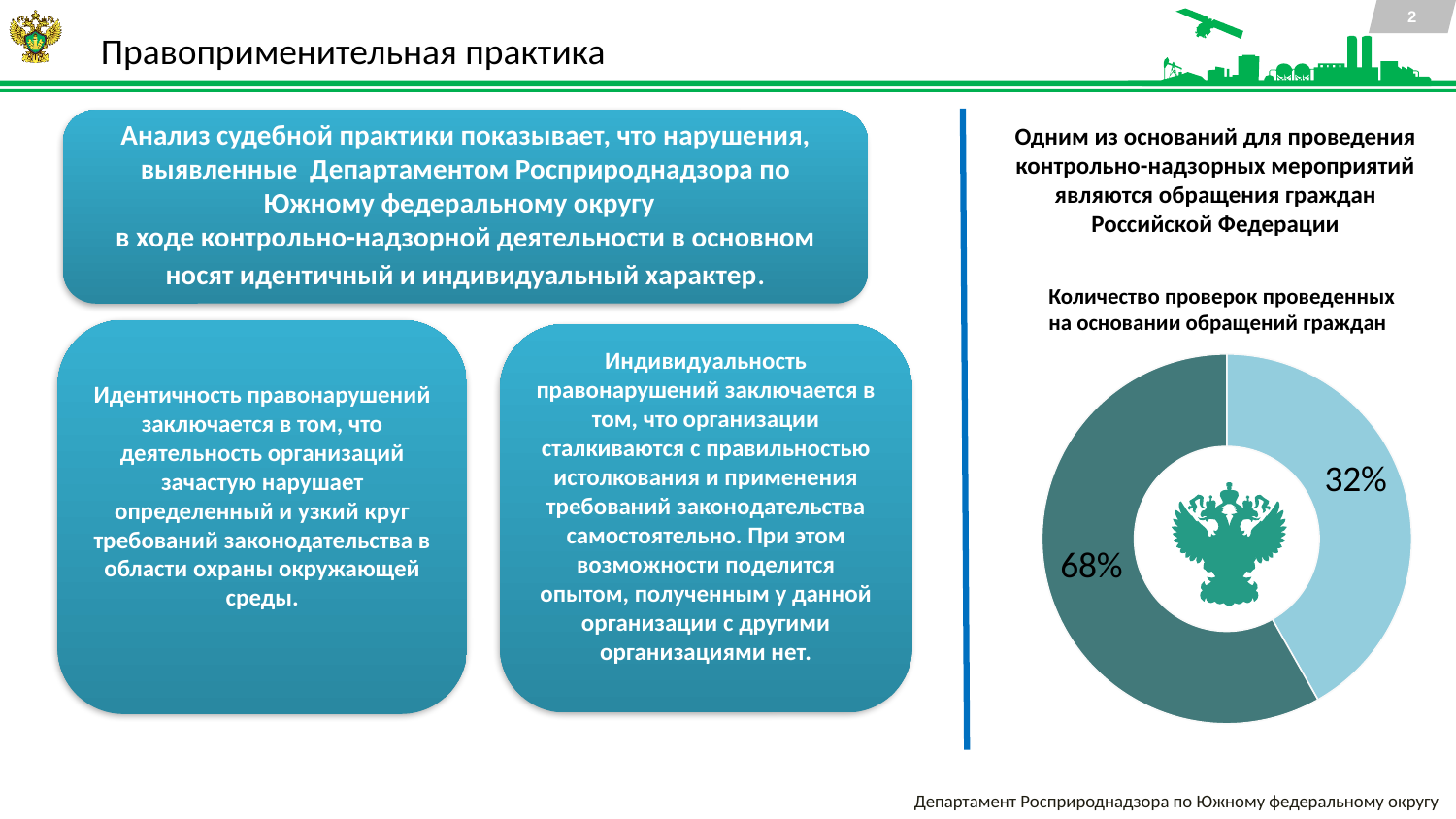
How many slices does the doughnut chart have? 2 What is the title of the chart on the slide? Количество проверок проведенных на основании обращений граждан Which slice of the doughnut chart is larger, the dark teal one or the light blue one? the dark teal one What is the value of the smallest slice in the doughnut chart? 32% What is the difference between the two slices of the doughnut chart? 36 percentage points What do the two slices of the doughnut chart add up to? 100% What is the value of the largest slice in the doughnut chart? 68% What value is shown for the light blue slice of the doughnut chart? 32% What value is shown for the dark teal slice of the doughnut chart? 68% Is the light blue slice of the doughnut chart greater or less than 50%? less What kind of chart is shown on the slide? doughnut chart What share of the doughnut chart does the larger slice represent? 68%